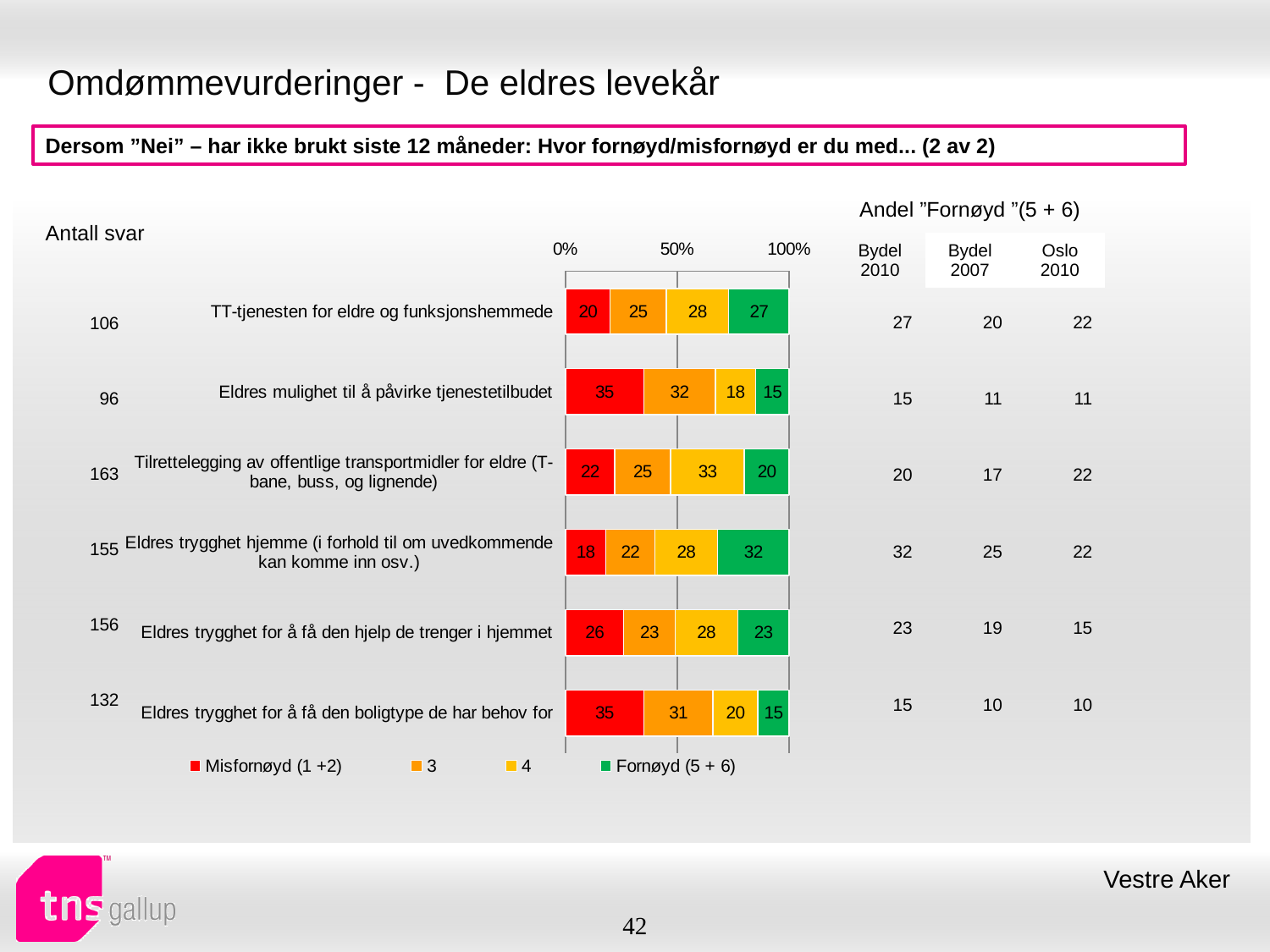
Which is larger for 'Eldres trygghet for å få den hjelp de trenger i hjemmet': the Misfornøyd (1 +2) value or the Fornøyd (5 + 6) value? Misfornøyd (1 +2) How many series does the chart legend list? 4 What is the difference between the Misfornøyd (1 +2) value and the Fornøyd (5 + 6) value for 'Eldres trygghet for å få den boligtype de har behov for'? 20 Which category has the lowest Misfornøyd (1 +2) value? Eldres trygghet hjemme (i forhold til om uvedkommende kan komme inn osv.) What is the Fornøyd (5 + 6) value for 'TT-tjenesten for eldre og funksjonshemmede'? 27 Which category has the highest Fornøyd (5 + 6) value? Eldres trygghet hjemme (i forhold til om uvedkommende kan komme inn osv.) How many categories (statements) are plotted in the chart? 6 What is the total of the stacked bar for 'TT-tjenesten for eldre og funksjonshemmede'? 100 What colour represents the Fornøyd (5 + 6) series in the chart? Green What kind of chart is shown on the slide? Stacked bar chart What is the value of series '4' for 'Tilrettelegging av offentlige transportmidler for eldre (T-bane, buss, og lignende)'? 33 What is the Misfornøyd (1 +2) value for 'Eldres mulighet til å påvirke tjenestetilbudet'? 35